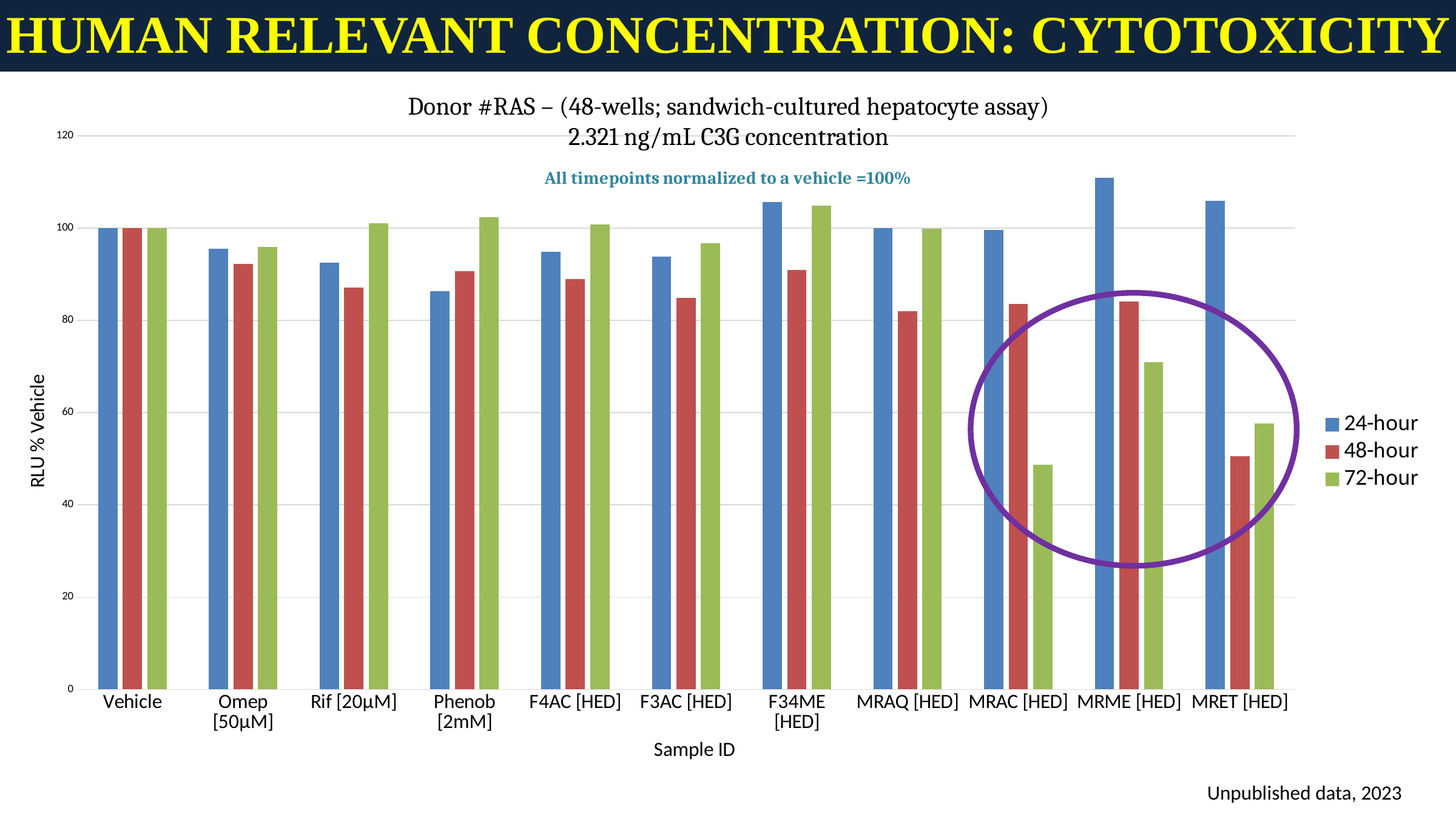
Which sample has the highest 24-hour value? MRME [HED] What kind of chart is shown on the slide? bar chart Which sample has the lowest 48-hour value? MRET [HED] Is the 24-hour value for MRME [HED] greater or less than 100? greater Is the 72-hour value for MRAC [HED] greater or less than 60? less How many series does the legend list? 3 Which is larger, the 72-hour value for MRAC [HED] or the 72-hour value for MRME [HED]? MRME [HED] Is the 72-hour value for MRET [HED] greater or less than 80? less Which sample has the lowest 72-hour value? MRAC [HED] How many sample IDs are shown along the x axis? 11 What is the 24-hour value for Vehicle? 100 What is the label of the y axis? RLU % Vehicle